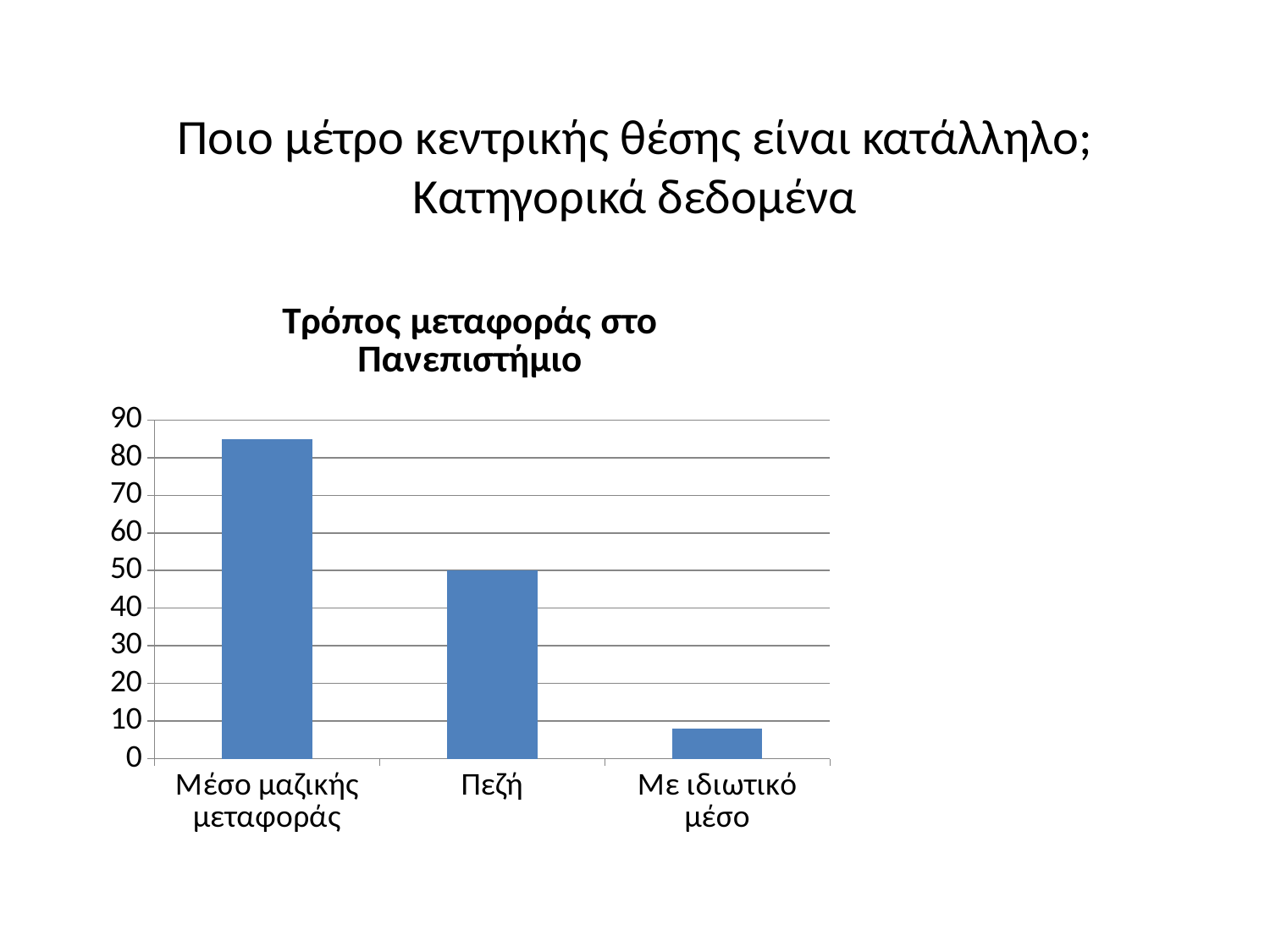
Which category has the highest bar? Μέσο μαζικής μεταφοράς Is the value for Με ιδιωτικό μέσο greater or less than 10? less How many categories are shown on the x axis of the chart? 3 What kind of chart is shown on the slide? bar chart Which category has the lowest bar? Με ιδιωτικό μέσο Do the bar values rise or fall from left to right along the x axis? fall What is the title of the chart? Τρόπος μεταφοράς στο Πανεπιστήμιο What is the value for Πεζή? 50 Which is larger, the value for Πεζή or the value for Με ιδιωτικό μέσο? Πεζή Is the value for Μέσο μαζικής μεταφοράς greater or less than 90? less What is the highest value shown on the vertical axis? 90 Is the value for Μέσο μαζικής μεταφοράς greater or less than 80? greater